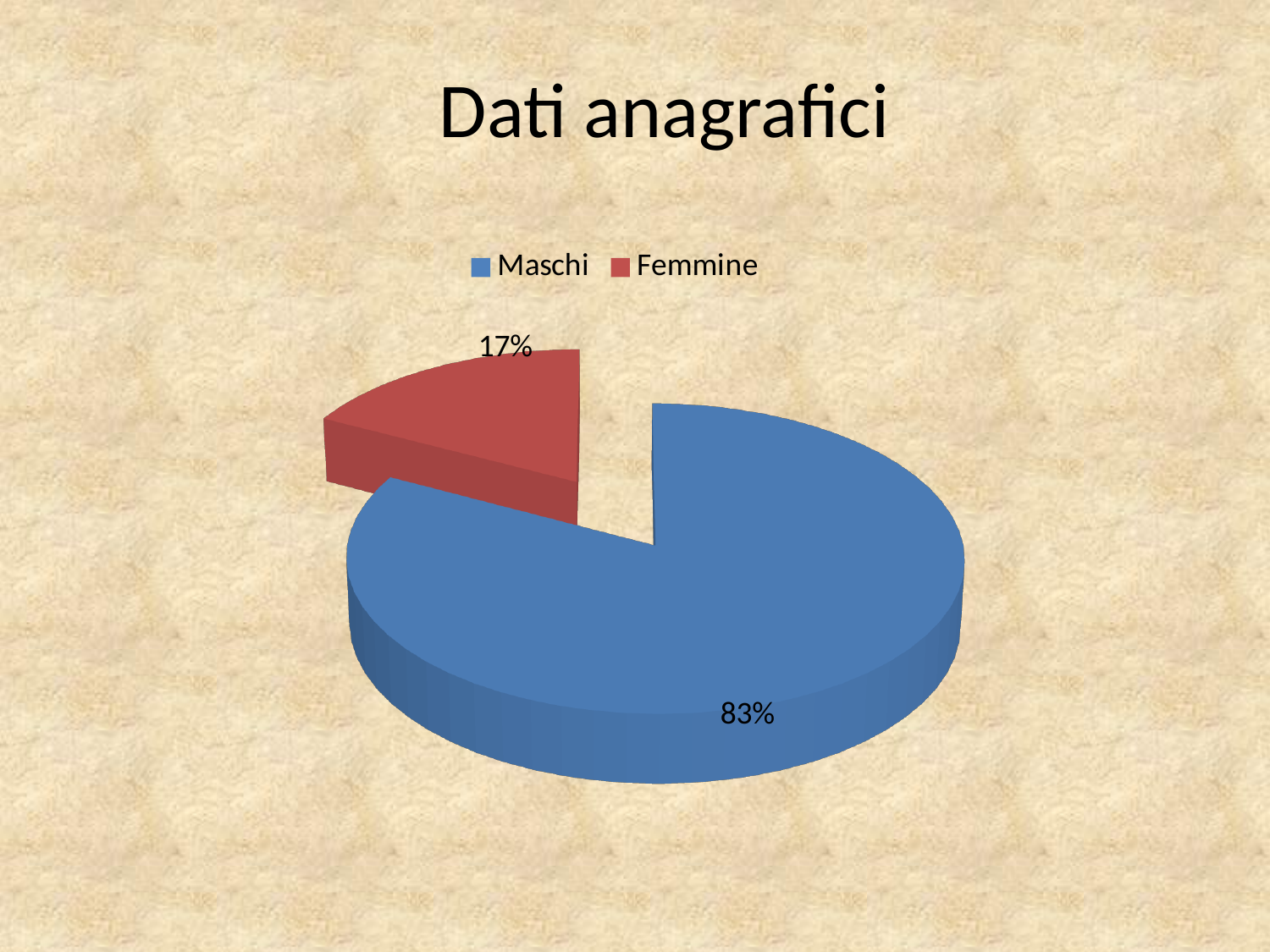
What colour is the Femmine slice? red What kind of chart is shown on the slide? pie chart How many entries does the legend list? 2 Which is larger, the Maschi slice or the Femmine slice? Maschi Which category has the largest slice of the pie? Maschi What is the title of the slide containing the chart? Dati anagrafici How many slices does the pie chart have? 2 What share of the pie does Maschi represent? 83% Which category has the smallest slice of the pie? Femmine What is the difference in percentage points between the Maschi and Femmine slices? 66 What share of the pie does Femmine represent? 17%